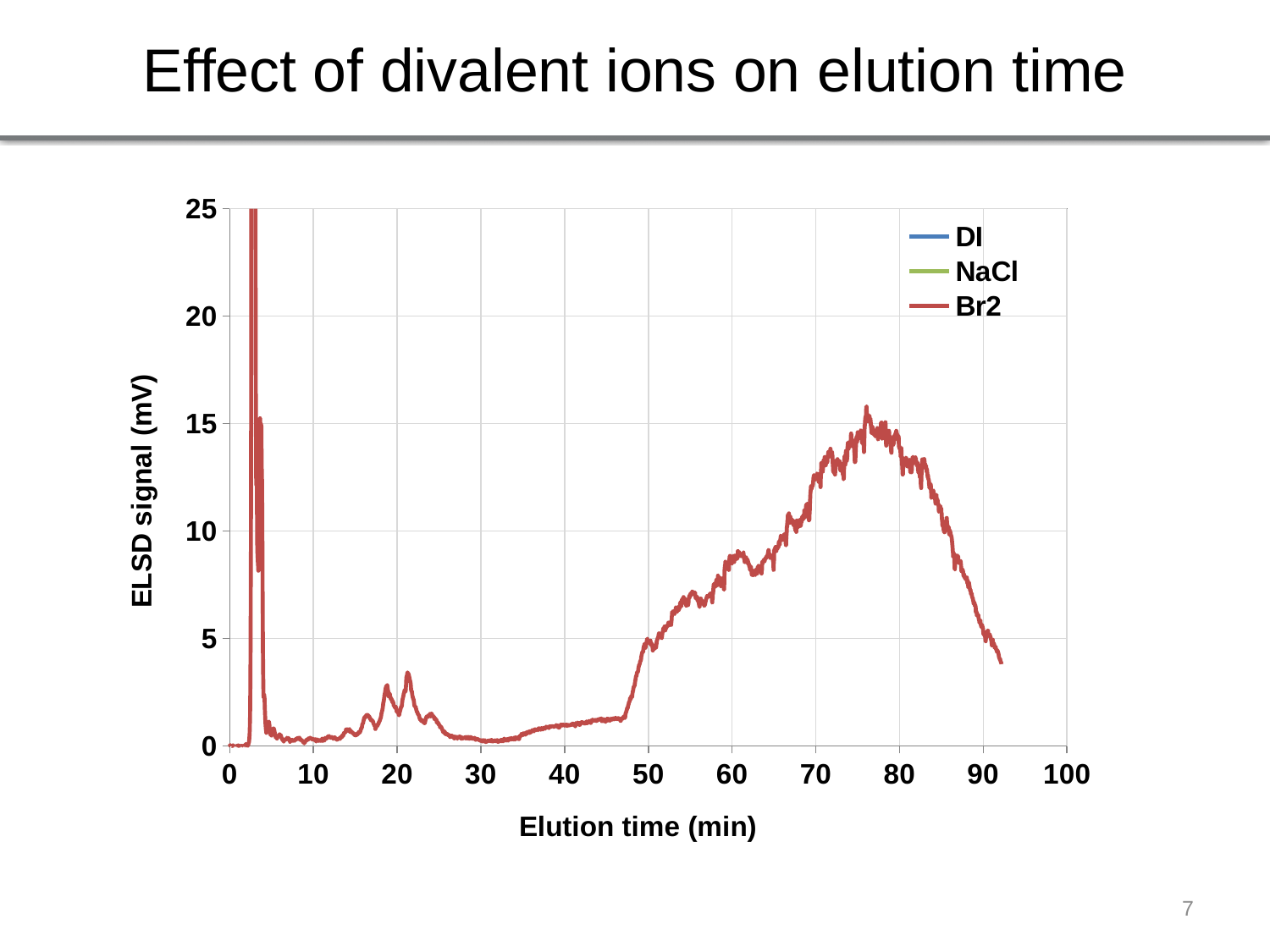
Is the Br2 signal at an elution time of 30 min greater or less than 5? less Is the Br2 signal at an elution time of 40 min greater or less than 5? less What is the highest value shown on the y axis? 25 What is the title of the chart? Effect of divalent ions on elution time How many series does the legend list? 3 Does the Br2 signal rise or fall between elution times of 80 min and 90 min? fall What kind of chart is shown on the slide? line chart What is the label of the y axis? ELSD signal (mV) Does the Br2 signal rise or fall between elution times of 50 min and 75 min? rise Which is larger, the Br2 signal at 70 min or at 20 min? 70 min Is the Br2 signal at an elution time of 60 min greater or less than 5? greater